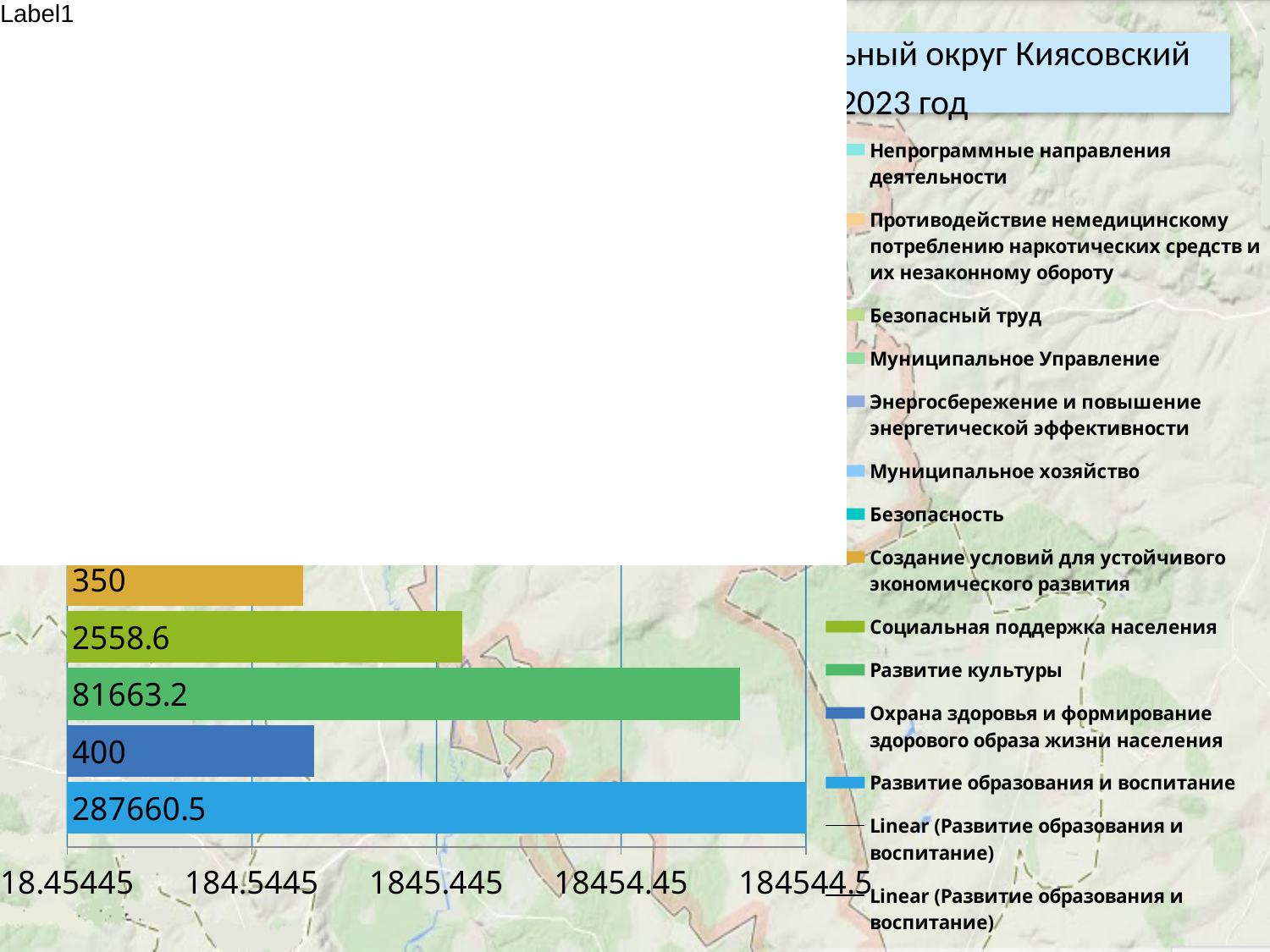
What kind of chart is shown on the slide? bar chart How many bars with data labels are visible on the chart? 5 Which of the visible bars has the highest value? Развитие образования и воспитание What value is shown for Социальная поддержка населения? 2558.6 Which of the visible bars has the lowest value? Создание условий для устойчивого экономического развития Which is larger: the value for Развитие культуры or the value for Социальная поддержка населения? Развитие культуры What value is shown for Развитие образования и воспитание? 287660.5 What value is shown for Развитие культуры? 81663.2 What value is shown for Охрана здоровья и формирование здорового образа жизни населения? 400 What value is shown for Создание условий для устойчивого экономического развития? 350 What is the difference between the values for Охрана здоровья и формирование здорового образа жизни населения and Создание условий для устойчивого экономического развития? 50 How many legend entries are labelled 'Linear (Развитие образования и воспитание)'? 2